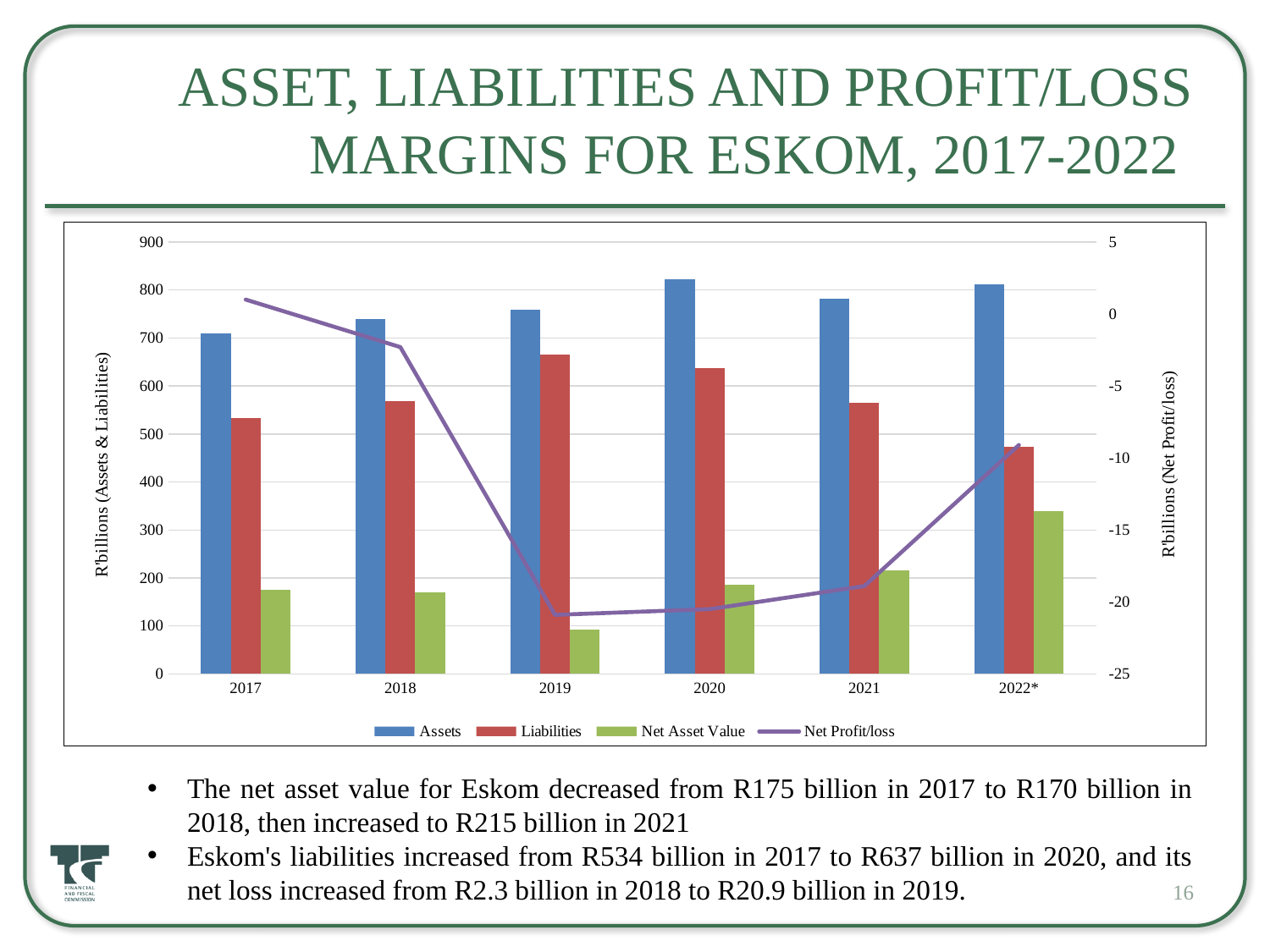
Which is larger in 2019, Assets or Liabilities? Assets How many series does the chart legend list? 4 Which year has the highest Liabilities bar? 2019 Which year has the lowest Net Asset Value bar? 2019 Which year has the lowest Liabilities bar? 2022* Does the Net Profit/loss line rise or fall from 2017 to 2019? Fall Is the value for Assets in 2020 greater or less than 800? greater What kind of chart is shown on the slide? Bar chart with a line series Is the value for Net Asset Value in 2019 greater or less than 100? less How many years are shown on the x axis of the chart? 6 In which year is the Net Profit/loss line at its highest point? 2017 Which year has the highest Net Asset Value bar? 2022*